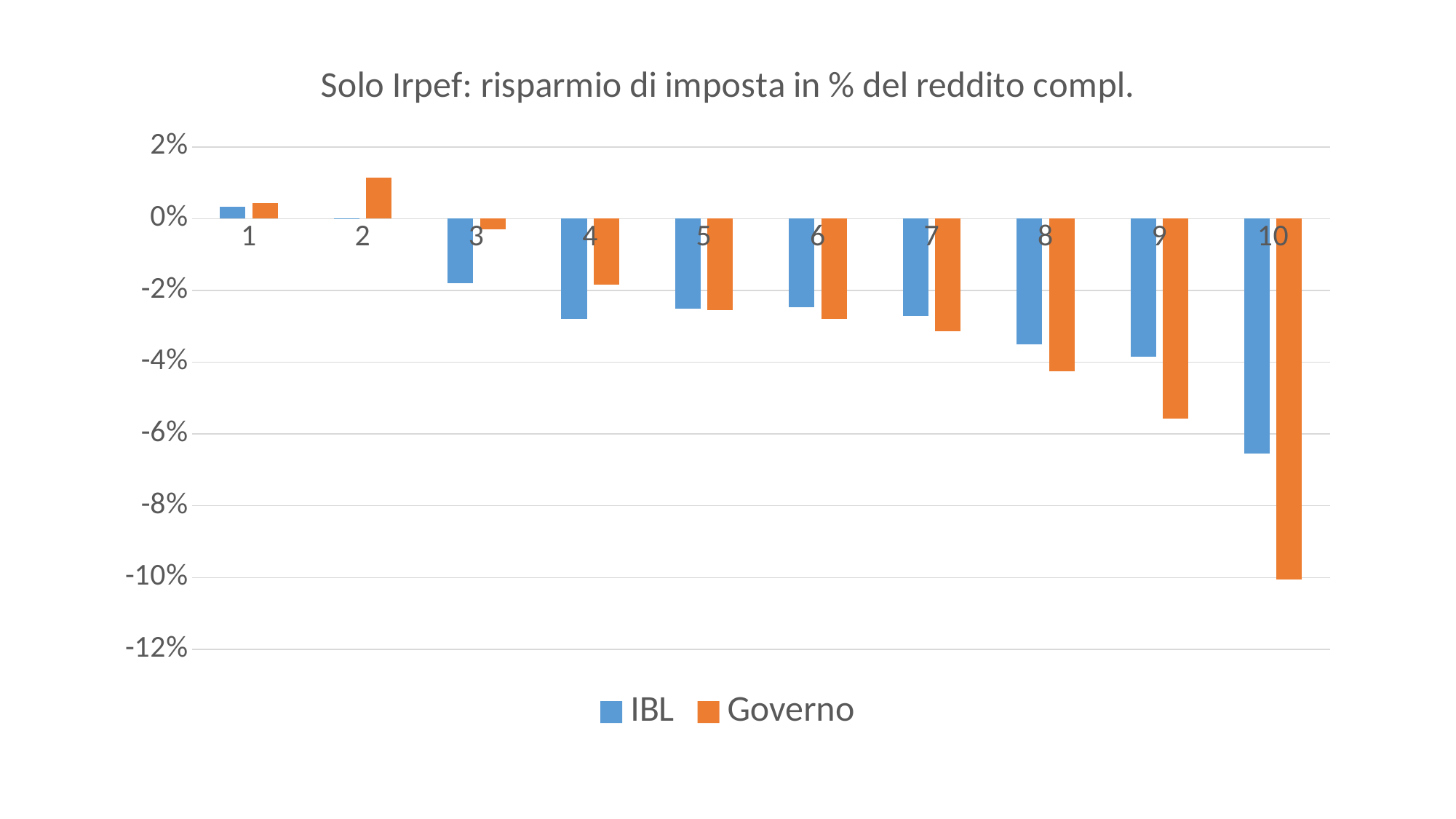
For category 10, which series has the lower value, IBL or Governo? Governo Is the IBL value for category 3 greater or less than -2%? greater Which category has the lowest value for the Governo series? 10 Is the Governo value for category 9 greater or less than -4%? less What kind of chart is shown on the slide? bar chart What is the title of the chart? Solo Irpef: risparmio di imposta in % del reddito compl. How many series does the legend list? 2 Which category has the lowest value for the IBL series? 10 How many categories are shown on the x axis? 10 Do the Governo values generally rise or fall from category 1 to category 10? fall Which category has the highest value for the Governo series? 2 Is the Governo value for category 10 greater or less than -8%? less